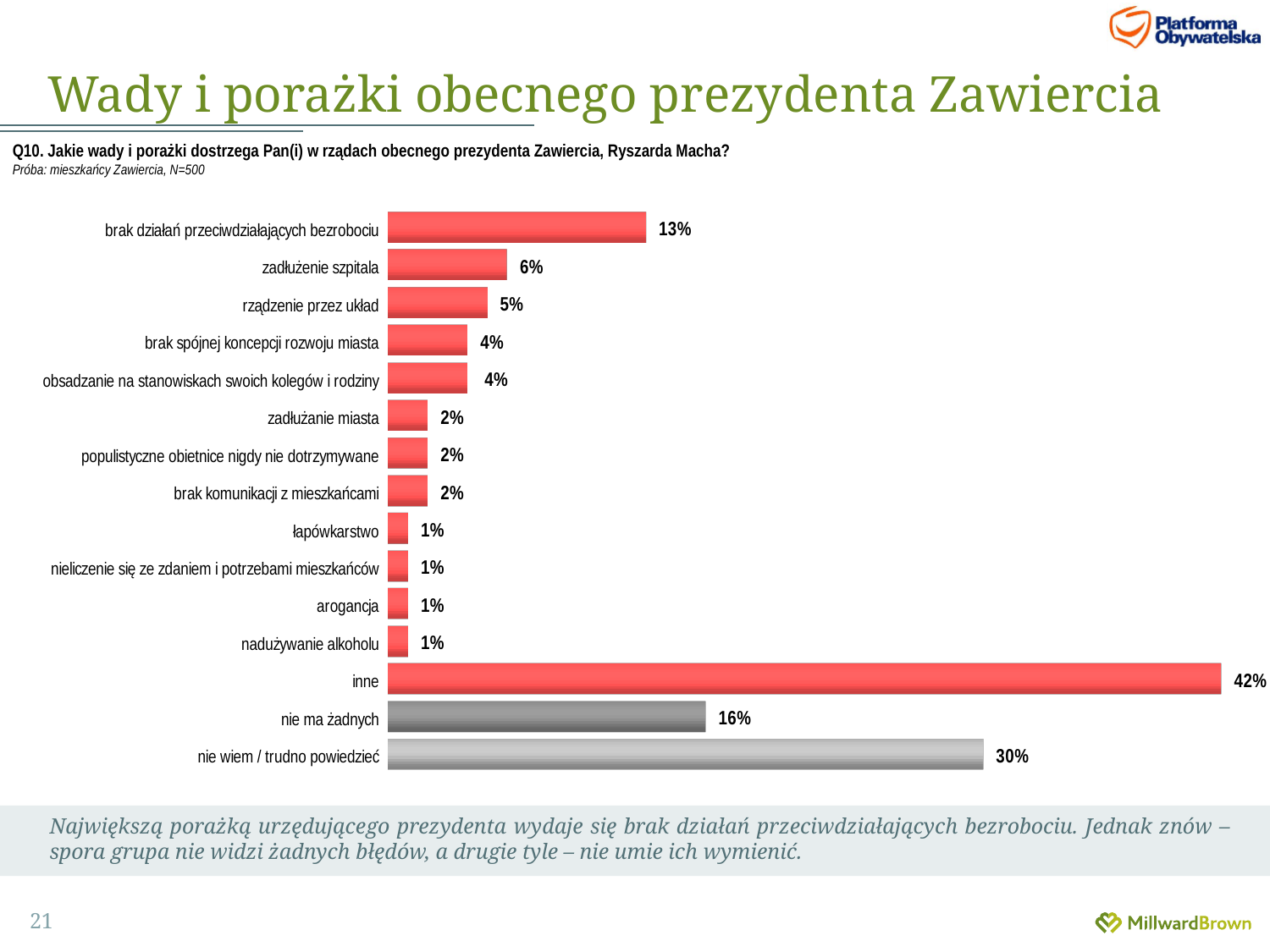
What is the value for "nie ma żadnych"? 16% What is the difference between the values for "inne" and "nie wiem / trudno powiedzieć"? 12% What kind of chart is shown on the slide? bar chart What is the value for "brak działań przeciwdziałających bezrobociu"? 13% Which category has the highest value? inne How many categories are shown in the chart? 15 Which is larger, the value for "rządzenie przez układ" or the value for "zadłużanie miasta"? rządzenie przez układ What is the value for "zadłużenie szpitala"? 6% What is the value for "nie wiem / trudno powiedzieć"? 30% What is the difference between the values for "brak działań przeciwdziałających bezrobociu" and "zadłużenie szpitala"? 7% What is the sample size (N) stated below the question text? N=500 Which is larger, the value for "nie ma żadnych" or the value for "nie wiem / trudno powiedzieć"? nie wiem / trudno powiedzieć